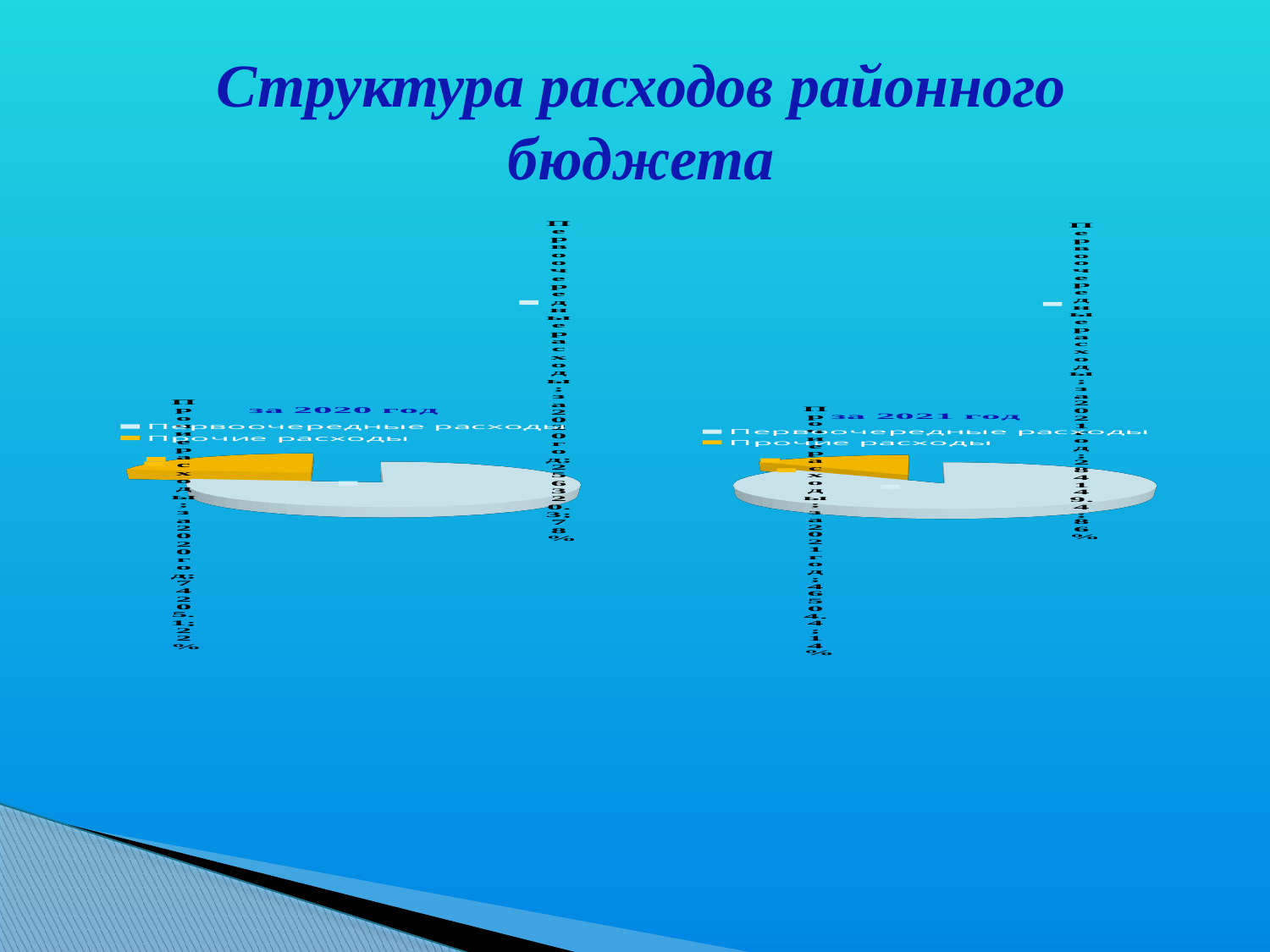
In the chart titled "за 2020 год", how many slices does the pie have? 2 In the chart titled "за 2020 год", what colour is the slice for Прочие расходы? yellow What kind of chart is the chart titled "за 2020 год"? pie chart In the chart titled "за 2021 год", how many slices does the pie have? 2 In the chart titled "за 2021 год", which category has the smallest slice? Прочие расходы In the chart titled "за 2021 год", how many entries does the legend list? 2 In the chart titled "за 2021 год", which slice is larger: Первоочередные расходы or Прочие расходы? Первоочередные расходы In the chart titled "за 2020 год", which category has the largest slice? Первоочередные расходы What is the title of the chart on the right side of the slide? за 2021 год What kind of chart is the chart titled "за 2021 год"? pie chart In the chart titled "за 2020 год", which slice is smaller: Первоочередные расходы or Прочие расходы? Прочие расходы In the chart titled "за 2020 год", how many entries does the legend list? 2